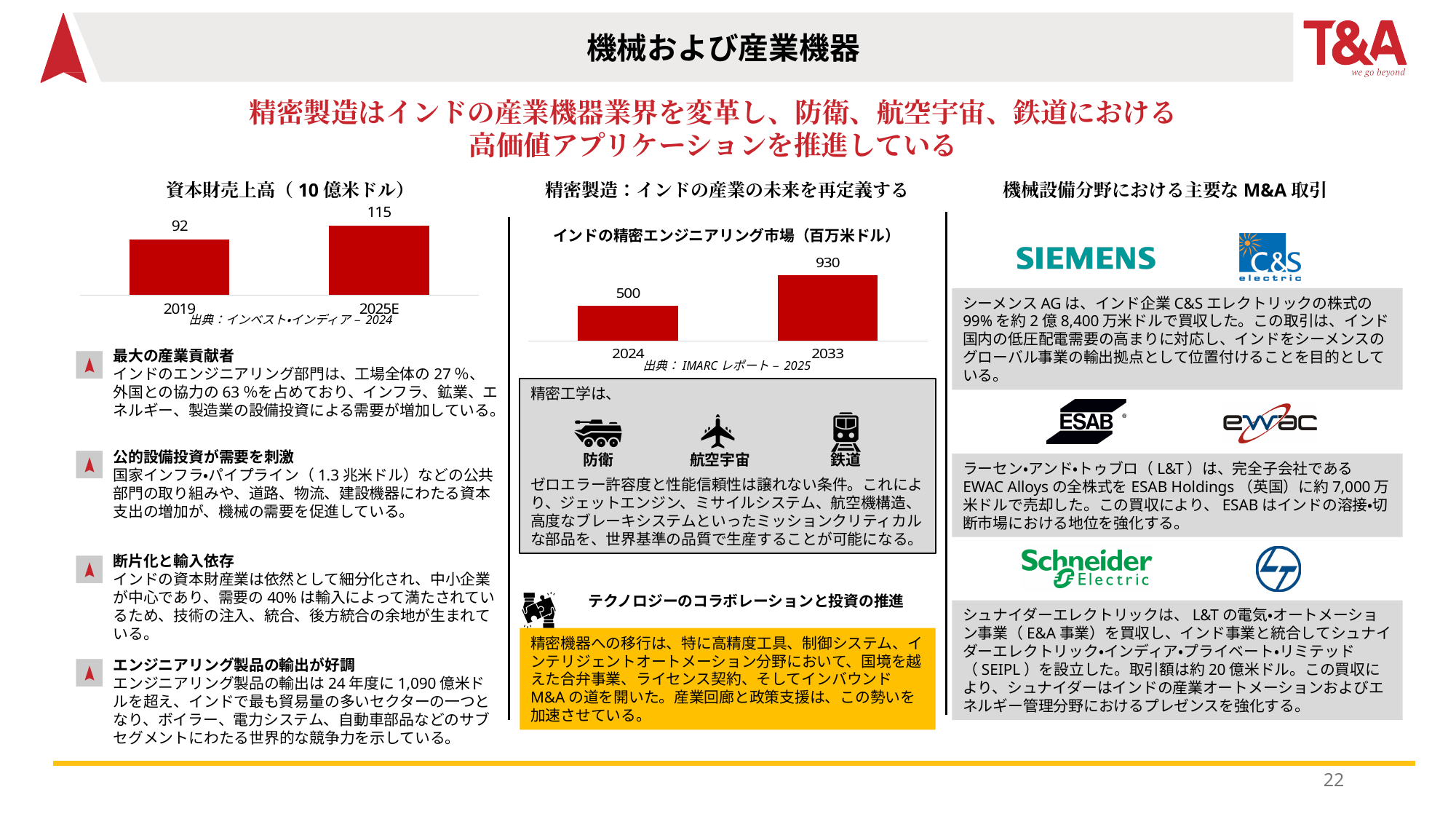
In the chart titled インドの精密エンジニアリング市場（百万米ドル）, what is the value for 2024? 500 What kind of chart is the one titled 資本財売上高（10億米ドル）? Bar chart In the chart titled 資本財売上高（10億米ドル）, what is the value for 2025E? 115 In the chart titled インドの精密エンジニアリング市場（百万米ドル）, what is the value for 2033? 930 In the chart titled インドの精密エンジニアリング市場（百万米ドル）, do the values rise or fall from 2024 to 2033? Rise In the chart titled 資本財売上高（10億米ドル）, what is the value for 2019? 92 In the chart titled 資本財売上高（10億米ドル）, what is the difference between the 2025E and 2019 values? 23 In the chart titled 資本財売上高（10億米ドル）, how many bars are plotted? 2 In the chart titled 資本財売上高（10億米ドル）, which year has the higher value, 2019 or 2025E? 2025E In the chart titled インドの精密エンジニアリング市場（百万米ドル）, what is the difference between the 2033 and 2024 values? 430 What source is cited below the chart titled インドの精密エンジニアリング市場（百万米ドル）? IMARC レポート – 2025 In the chart titled インドの精密エンジニアリング市場（百万米ドル）, which year has the lowest value? 2024